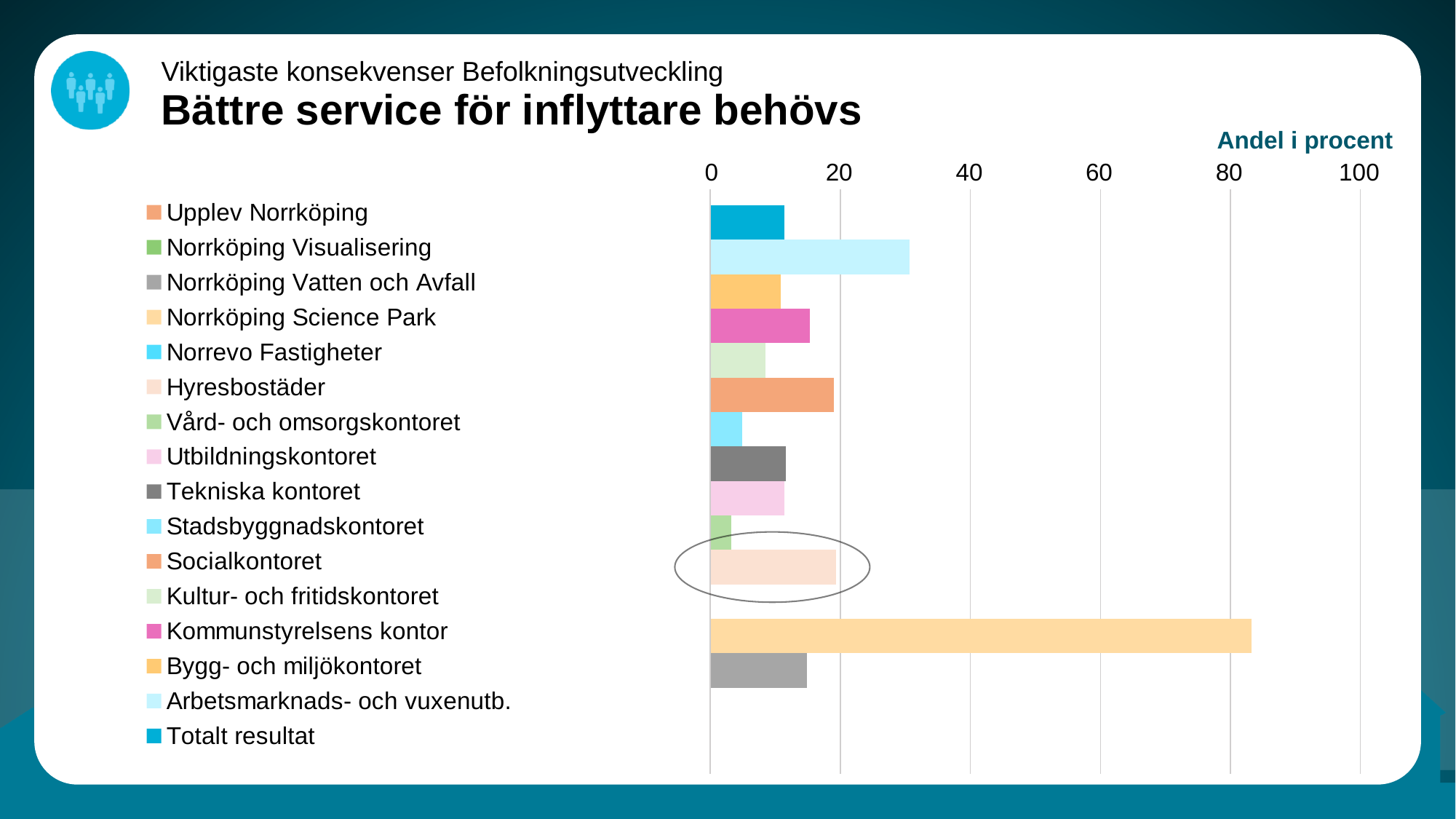
Which legend entry has the longest bar in the chart? Norrköping Science Park Which is larger, the value for Socialkontoret or the value for Stadsbyggnadskontoret? Socialkontoret How many entries does the chart's legend list? 16 Is the value for Totalt resultat greater or less than 20? less Is the value for Arbetsmarknads- och vuxenutb. greater or less than 20? greater Is the value for Norrköping Science Park greater or less than 80? greater What is the title of the slide's chart area, shown above the axis? Andel i procent Which is larger, the value for Arbetsmarknads- och vuxenutb. or the value for Kommunstyrelsens kontor? Arbetsmarknads- och vuxenutb. What is the highest value shown on the chart's horizontal axis? 100 What kind of chart is shown on the slide? bar chart